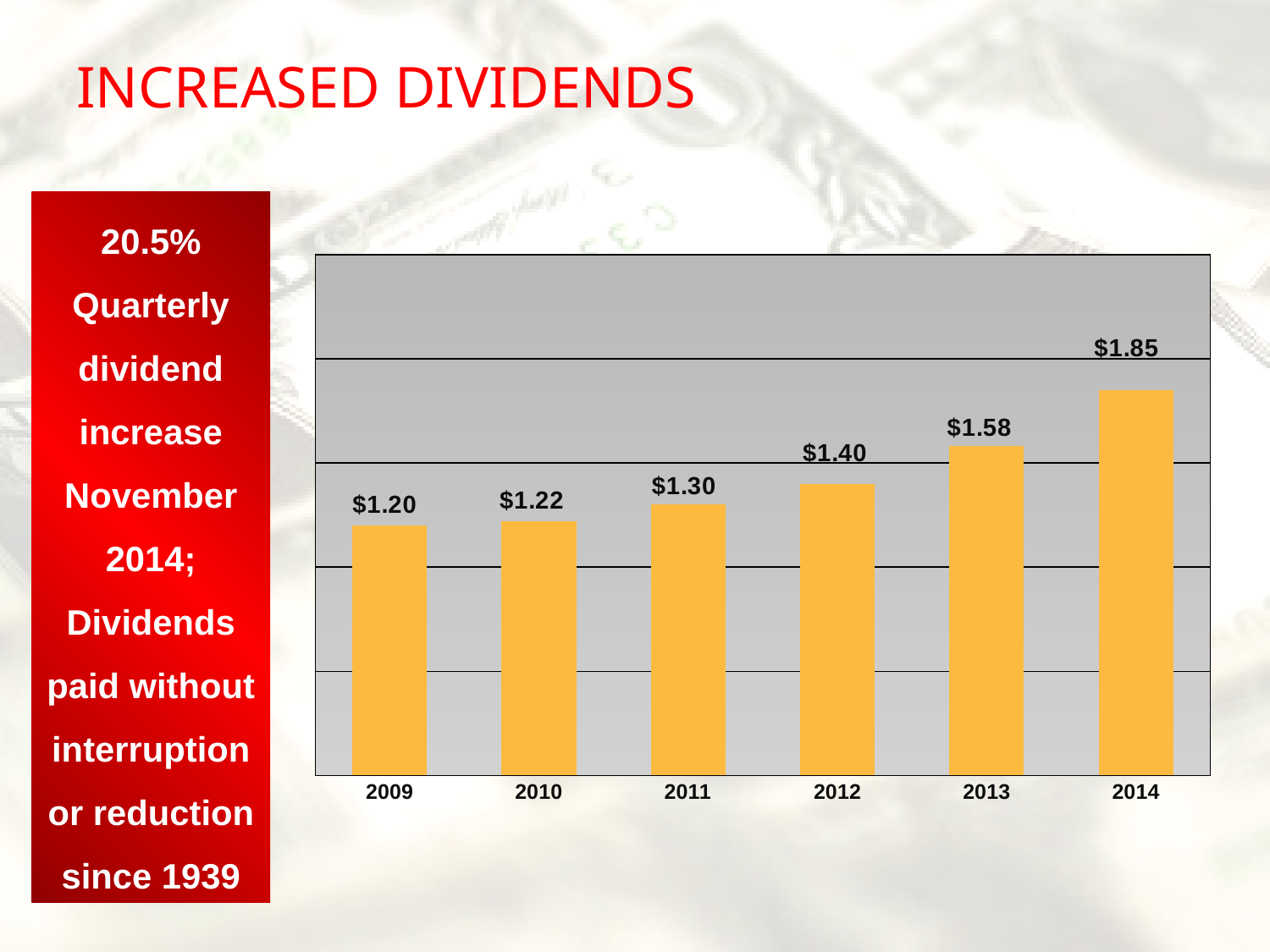
Which year has a larger dividend value, 2011 or 2013? 2013 What kind of chart is shown on the slide? Bar chart What is the difference between the dividend values for 2014 and 2013? $0.27 How many years are shown on the chart? 6 Which year has the lowest dividend value? 2009 Do the dividend values rise or fall from 2009 to 2014? Rise What is the dividend value shown for 2009? $1.20 What is the title of the slide containing the chart? INCREASED DIVIDENDS What is the difference between the dividend values for 2012 and 2009? $0.20 What is the dividend value shown for 2014? $1.85 Which year has the highest dividend value? 2014 What is the dividend value shown for 2012? $1.40